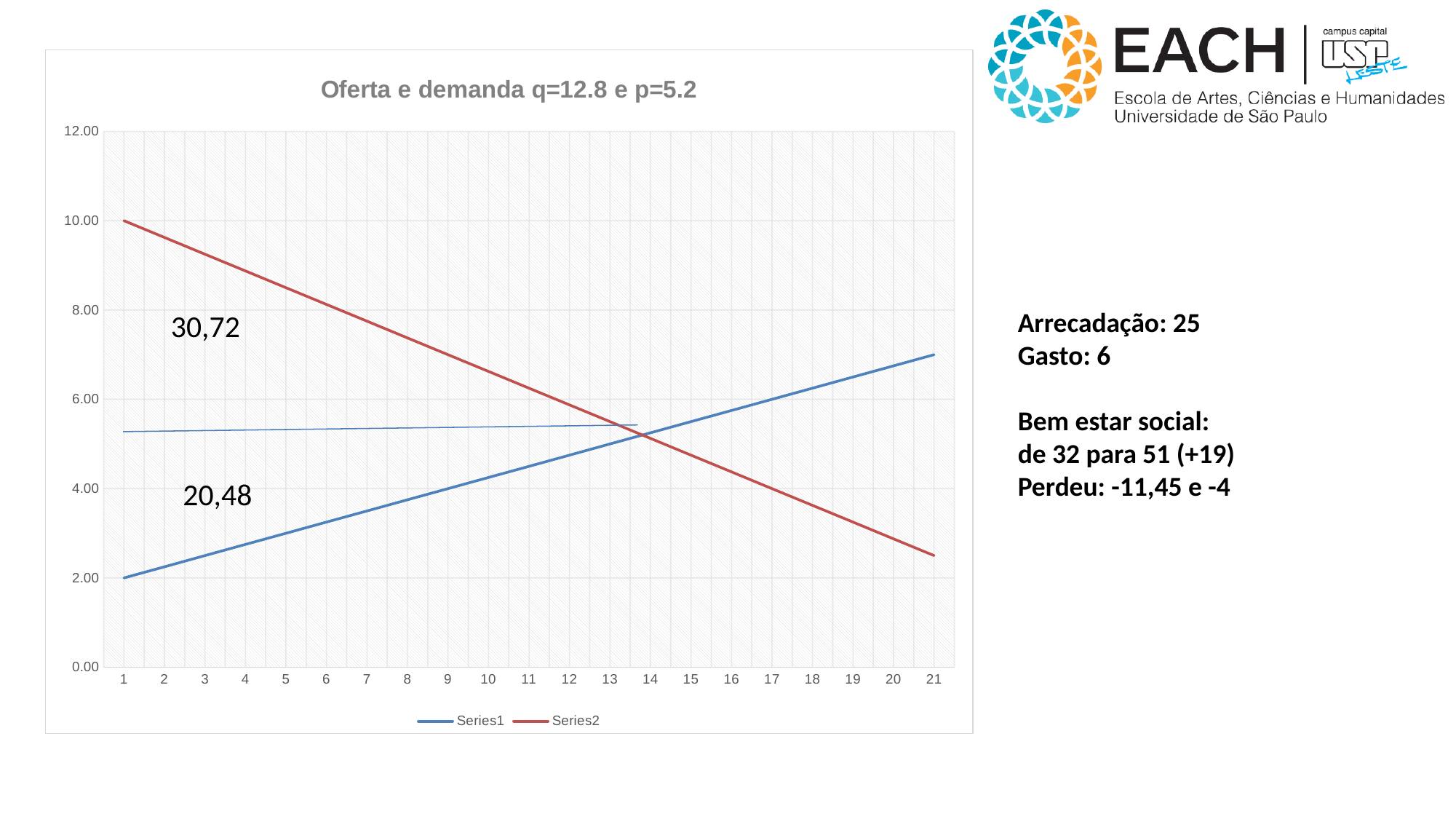
Is the value of Series1 at x = 21 greater or less than 6.00? greater Is the value of Series2 at x = 21 greater or less than 4.00? less How many points are labelled along the x axis? 21 Does Series2 rise or fall as the x axis goes from 1 to 21? fall How many series does the legend list? 2 What kind of chart is shown on the slide? line chart What colour is the line for Series2? red What is the title of the chart? Oferta e demanda q=12.8 e p=5.2 What is the value of Series2 at x = 1? 10.00 What is the value of Series1 at x = 1? 2.00 Does Series1 rise or fall as the x axis goes from 1 to 21? rise At x = 5, which series has the larger value, Series1 or Series2? Series2